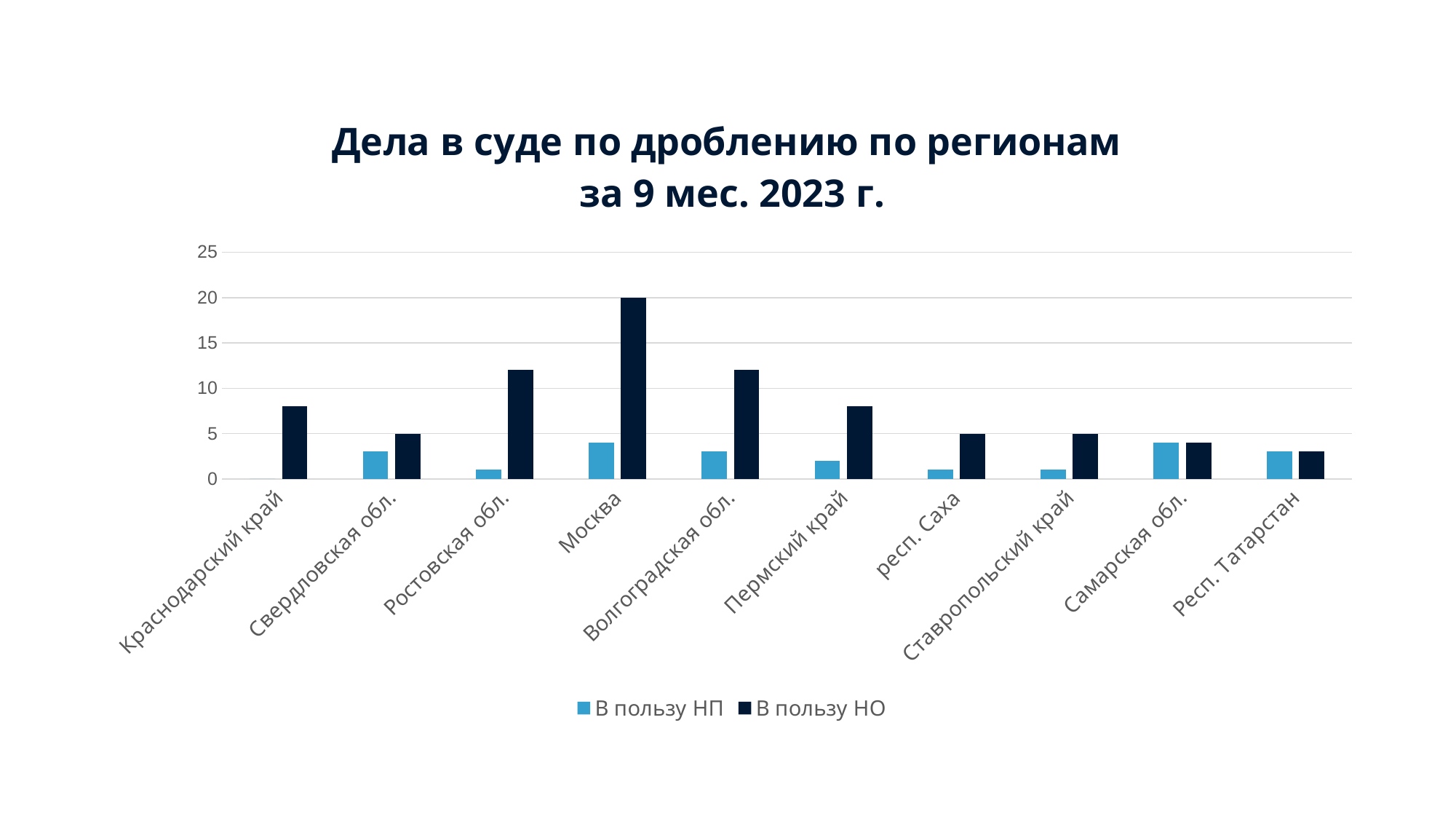
Is the value for Краснодарский край in the series "В пользу НО" greater or less than 10? less For Волгоградская обл., which series has the larger value, "В пользу НП" or "В пользу НО"? В пользу НО How many series does the legend list? 2 How many regions are shown on the x axis? 10 Which region has the highest value for the series "В пользу НО"? Москва What is the value for Москва in the series "В пользу НО"? 20 What is the title of the chart? Дела в суде по дроблению по регионам за 9 мес. 2023 г. Which series is shown in light blue in the legend? В пользу НП What kind of chart is shown on the slide? bar chart Is the value for Пермский край in the series "В пользу НП" greater or less than 5? less Is the value for Ростовская обл. in the series "В пользу НО" greater or less than 10? greater What is the value for Свердловская обл. in the series "В пользу НО"? 5